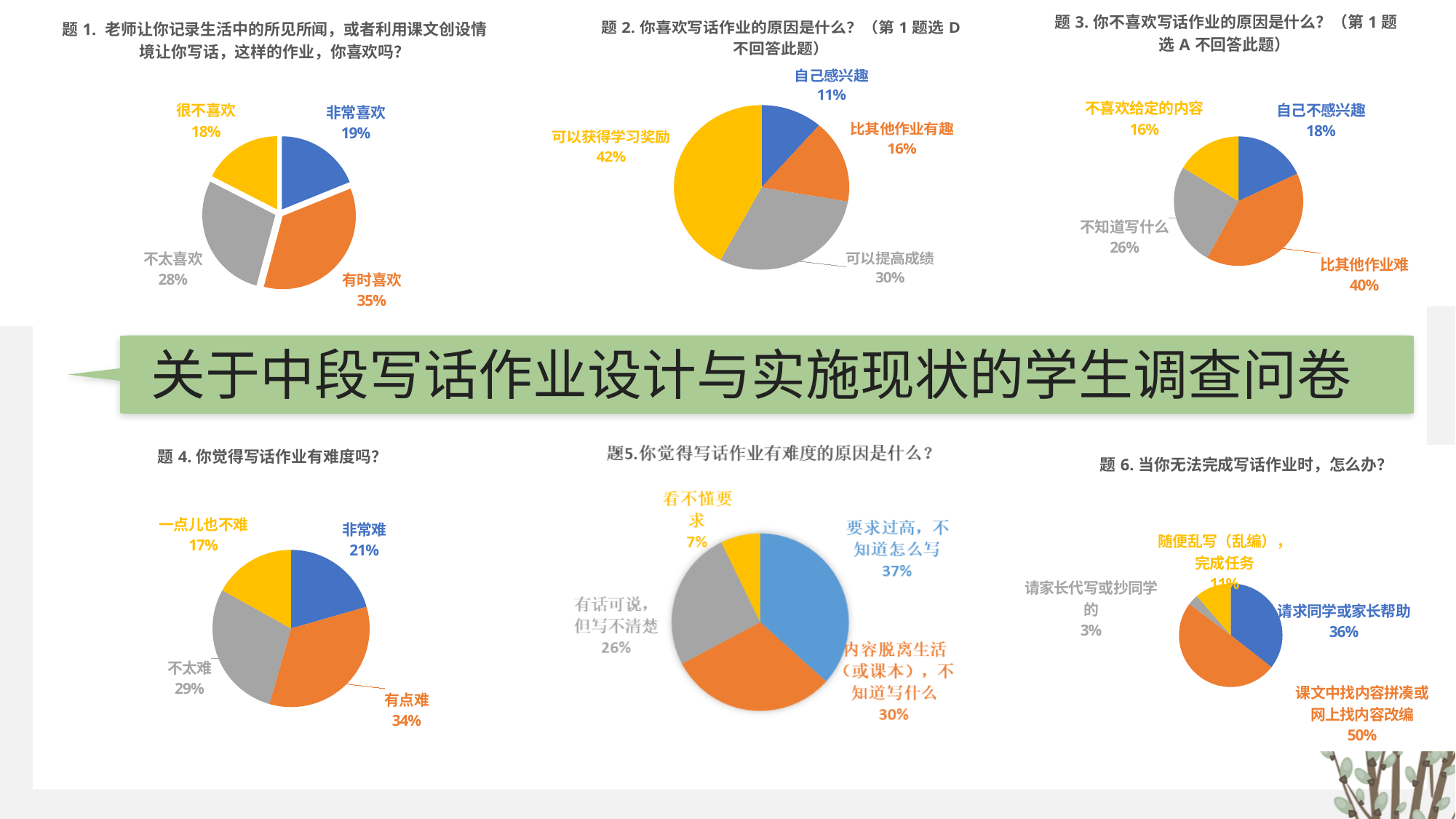
In the 题5 pie chart (bottom middle), which reason has the smallest share? 看不懂要求 In the 题 4 pie chart (bottom left), how many categories are shown? 4 In the 题 3 pie chart (top right), which is larger: 不知道写什么 or 自己不感兴趣? 不知道写什么 In the 题5 pie chart (bottom middle), what is the share for 要求过高，不知道怎么写? 37% In the 题 3 pie chart (top right), what percentage chose 比其他作业难? 40% In the 题 6 pie chart (bottom right), which option has the largest share? 课文中找内容拼凑或网上找内容改编 What type of chart is used for 题 6 (bottom right)? Pie chart In the 题 2 pie chart (top middle), what is the difference between the shares for 可以提高成绩 and 自己感兴趣? 19% In the 题 1 pie chart (top left), which category has the smallest share? 很不喜欢 In the 题 2 pie chart (top middle), which reason has the largest share? 可以获得学习奖励 In the 题 1 pie chart (top left), what percentage of students chose 有时喜欢? 35% In the 题 4 pie chart (bottom left), what percentage chose 不太难? 29%